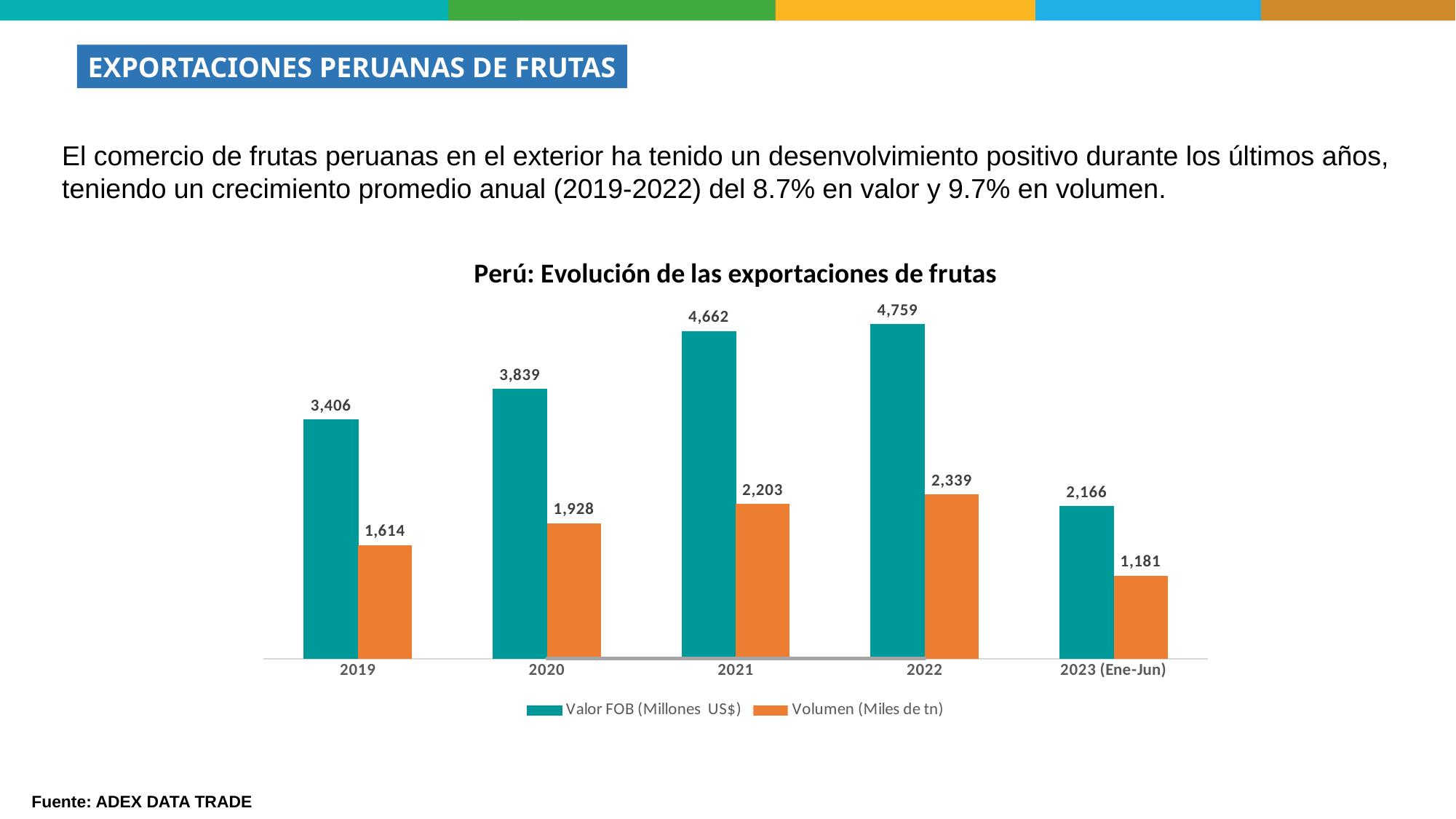
What is the difference in Valor FOB (Millones US$) between 2022 and 2019? 1,353 Which is larger, the Volumen (Miles de tn) for 2022 or for 2021? 2022 Does the Valor FOB (Millones US$) rise or fall from 2019 to 2022? Rise Which year has the highest Valor FOB (Millones US$)? 2022 What is the Volumen (Miles de tn) value for 2019? 1,614 What is the Valor FOB (Millones US$) value for 2021? 4,662 How many categories are shown on the x axis? 5 What is the difference in Volumen (Miles de tn) between 2021 and 2020? 275 Which category has the lowest Volumen (Miles de tn)? 2023 (Ene-Jun) What kind of chart is shown on the slide? Bar chart How many series does the legend list? 2 What is the Valor FOB (Millones US$) value for 2023 (Ene-Jun)? 2,166